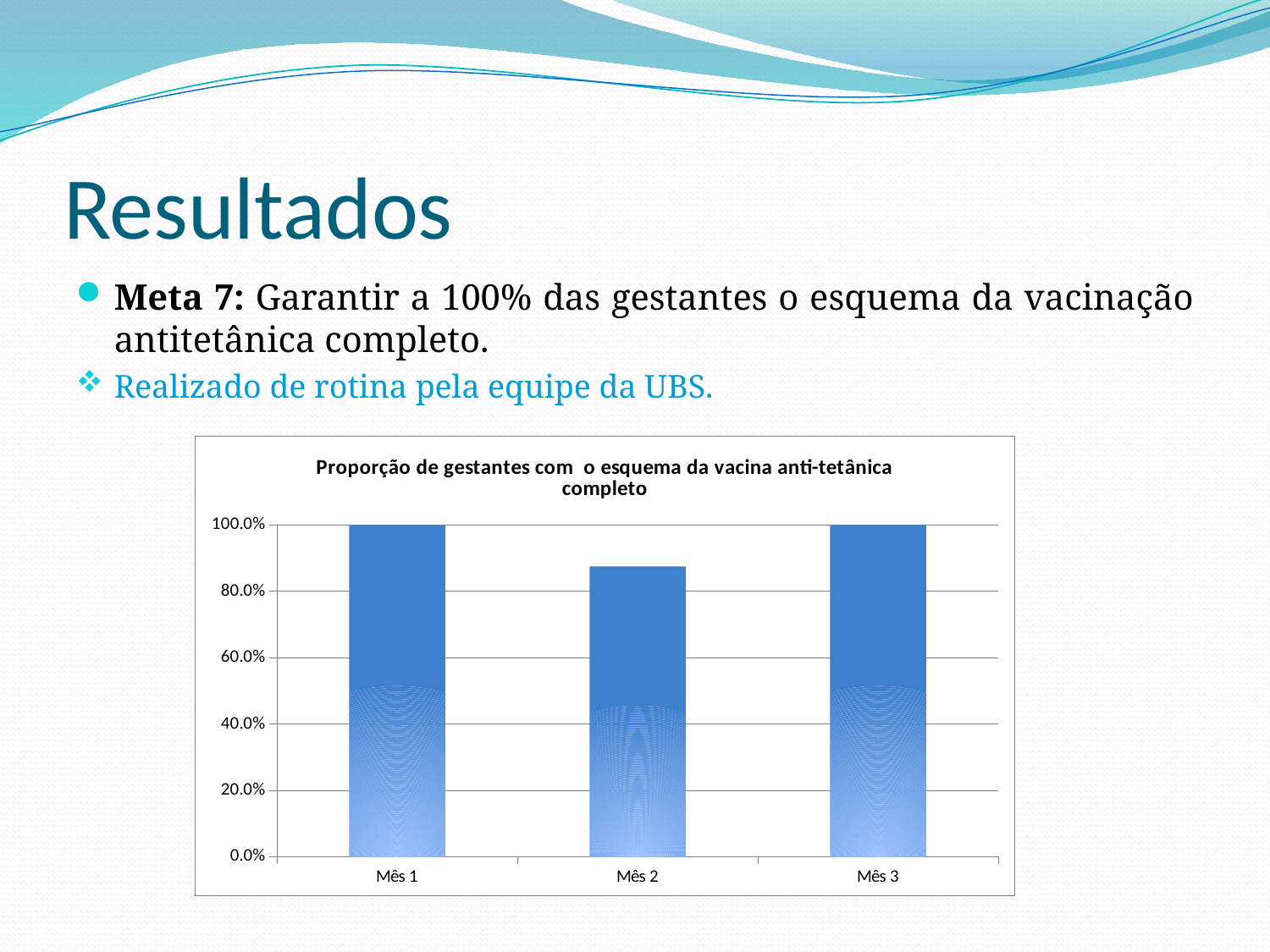
What is the highest value shown on the y axis? 100.0% What is the title of the chart? Proporção de gestantes com o esquema da vacina anti-tetânica completo How many months are shown on the x axis? 3 Which is larger, the value for Mês 1 or the value for Mês 2? Mês 1 What is the difference between the values for Mês 1 and Mês 3? 0.0% Which month has the lowest value? Mês 2 What is the value for Mês 1? 100.0% What kind of chart is shown on the slide? bar chart Is the value for Mês 2 greater or less than 100.0%? less Which is larger, the value for Mês 2 or the value for Mês 3? Mês 3 What is the value for Mês 3? 100.0% Is the value for Mês 2 greater or less than 80.0%? greater